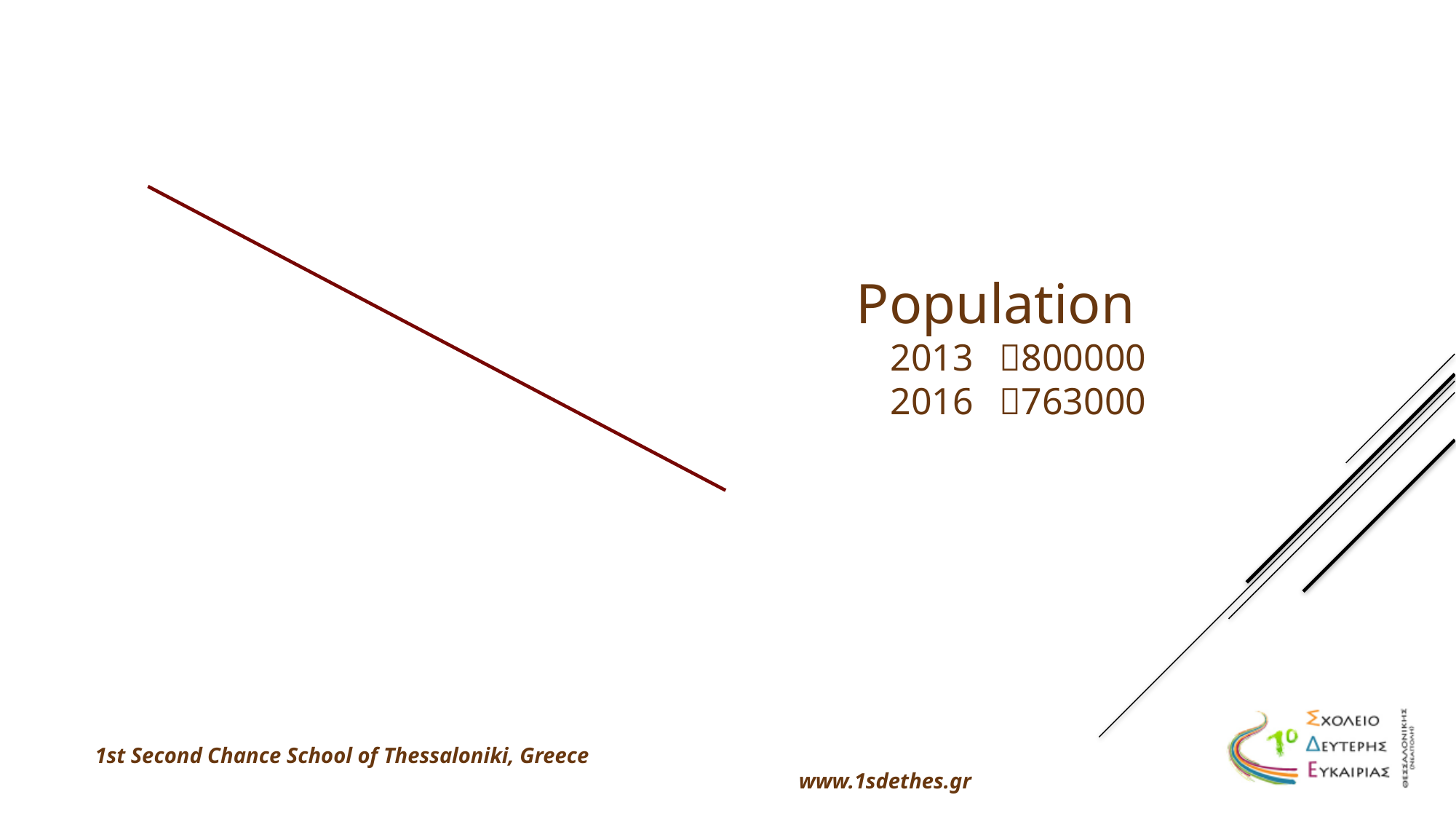
What kind of chart is the red line on the slide? line chart What population value is listed for 2016 on the slide? 763000 What is the title shown next to the chart on the slide? Population What population value is listed for 2013 on the slide? 800000 How many years are listed with population values on the slide? 2 What is the difference between the 2013 and 2016 population values listed on the slide? 37000 Which year has the larger population value listed, 2013 or 2016? 2013 Does the red line on the slide rise or fall from left to right? fall What colour is the line on the slide? dark red